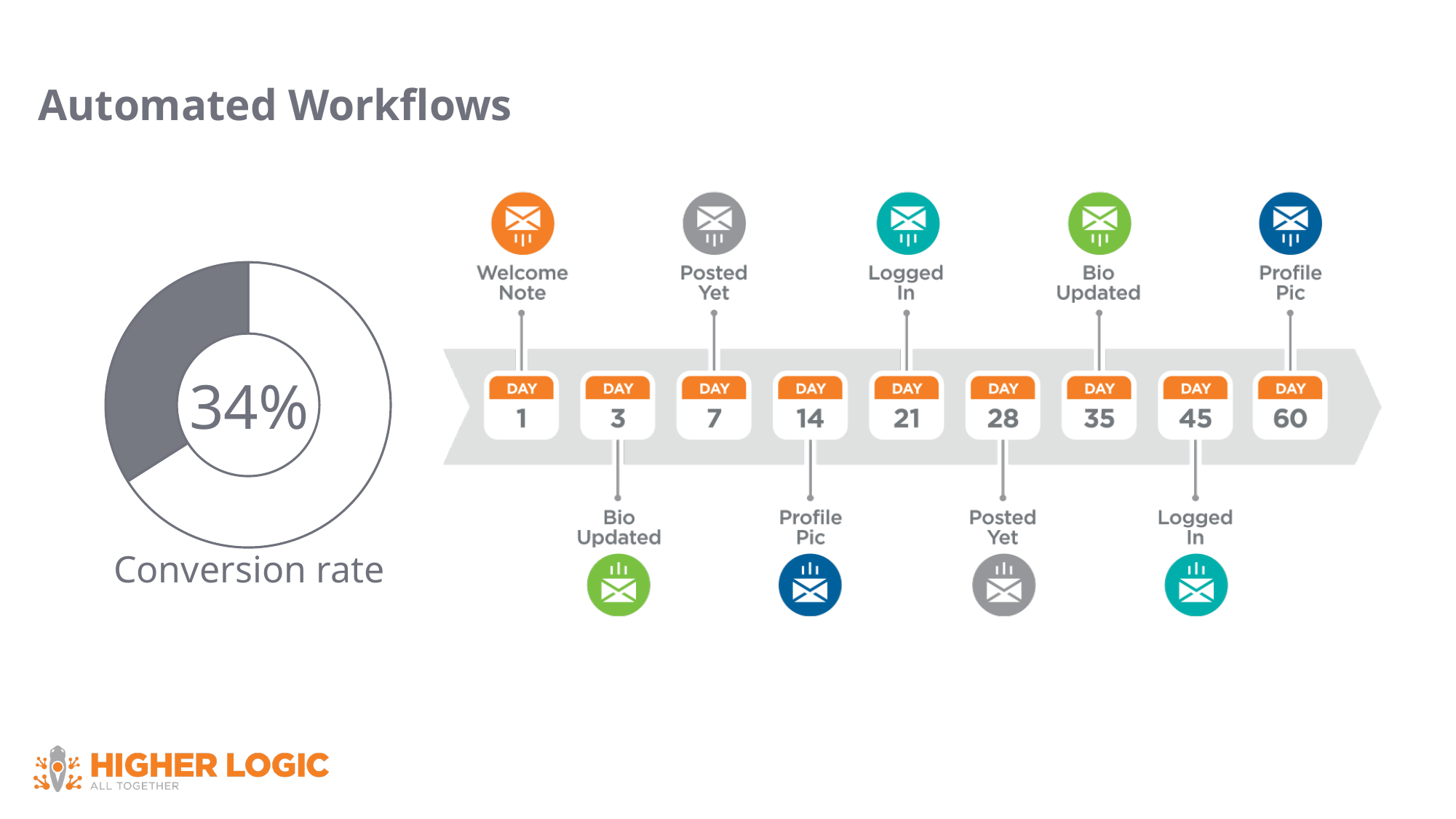
What is the label printed beneath the donut chart? Conversion rate What share of the donut chart is left unfilled (white)? 66% What conversion rate does the donut chart on the left show? 34% Is the filled portion of the donut chart greater or less than 25%? greater What share of the donut chart is filled in dark grey? 34% How many day markers are shown on the timeline to the right of the donut chart? 9 What is the first day shown on the timeline to the right of the donut chart? 1 What is the title of the slide containing the conversion rate donut chart? Automated Workflows Is the conversion rate shown in the donut chart greater or less than 50%? less What kind of chart is used to show the conversion rate on the left of the slide? Donut (pie) chart What is the last day shown on the timeline to the right of the donut chart? 60